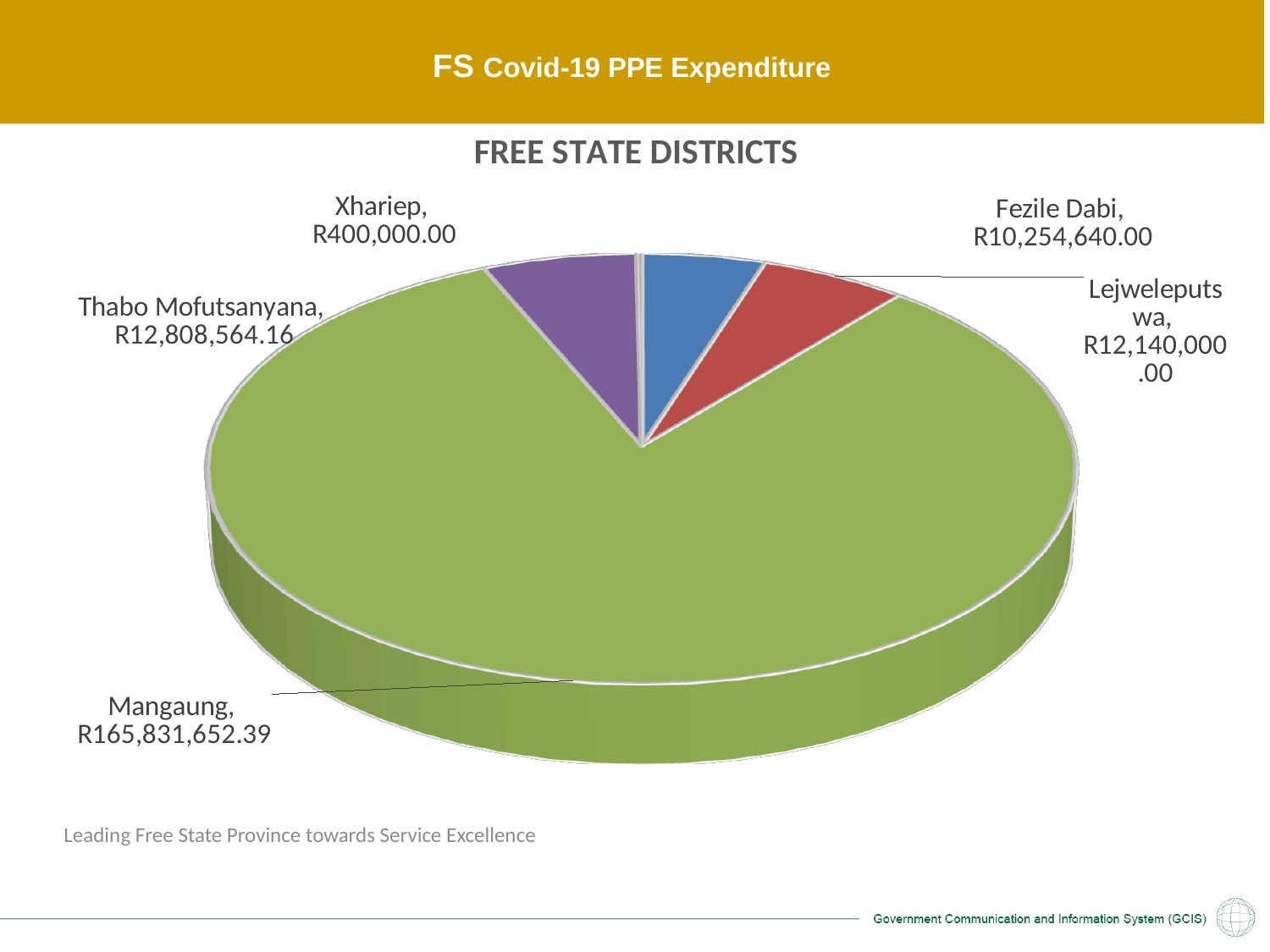
How many districts are shown in the pie chart? 5 What is the title of the chart? FREE STATE DISTRICTS What is the PPE expenditure value for Mangaung? R165,831,652.39 What is the value shown for Xhariep? R400,000.00 What is the value shown for Fezile Dabi? R10,254,640.00 Which has the larger value, Thabo Mofutsanyana or Lejweleputswa? Thabo Mofutsanyana Which district has the smallest value in the chart? Xhariep Which district has the largest slice of the pie? Mangaung What type of chart is shown on the slide? Pie chart What is the difference between the values for Lejweleputswa and Fezile Dabi? R1,885,360.00 What is the difference between the values for Thabo Mofutsanyana and Lejweleputswa? R668,564.16 What is the value shown for Thabo Mofutsanyana? R12,808,564.16